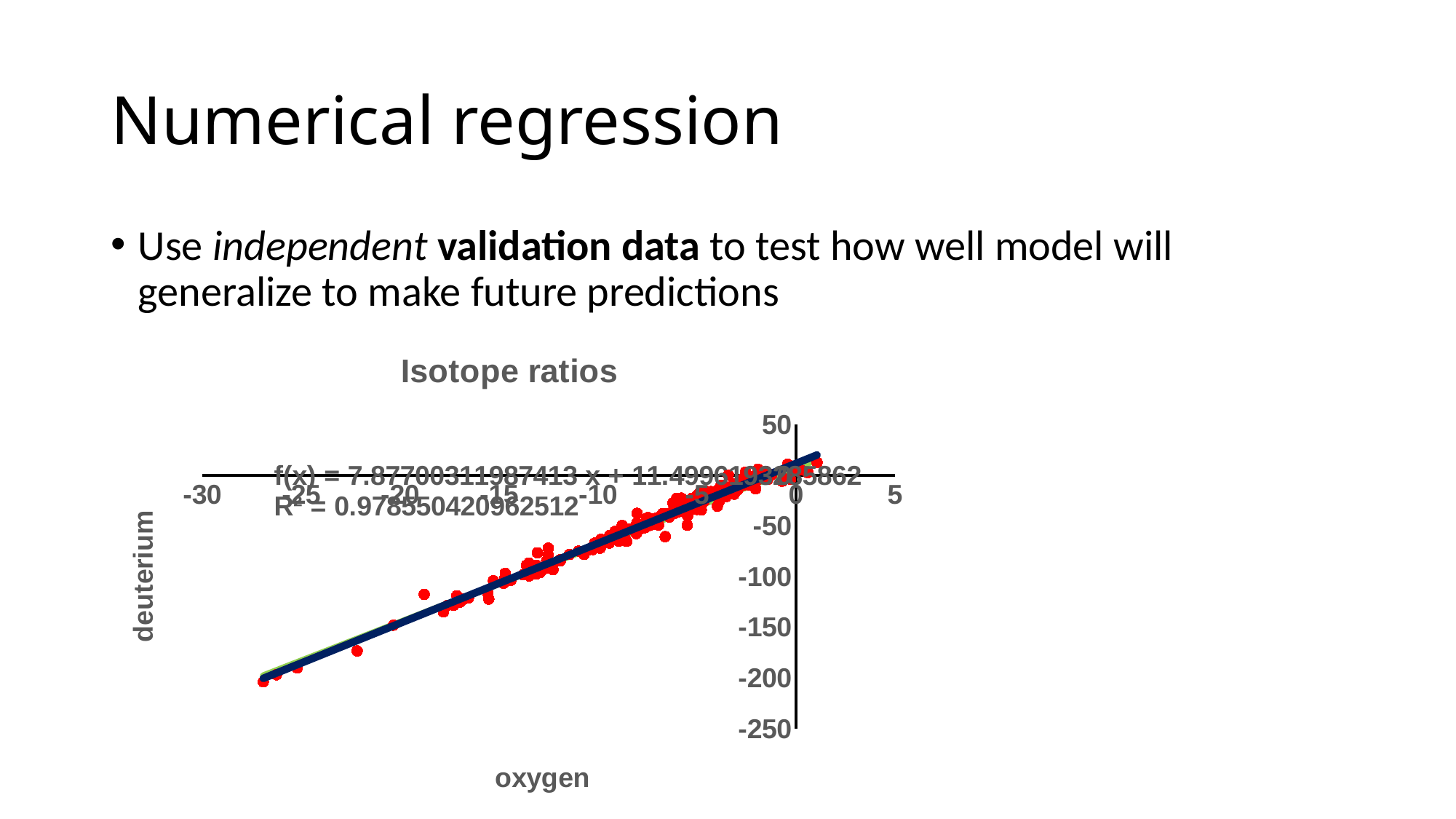
What is the label of the x axis of the chart? oxygen Is the oxygen value of the leftmost plotted point greater or less than -20? less What is the title of the chart? Isotope ratios What kind of chart is shown on the slide? scatter chart What is the slope coefficient of x in the trendline equation printed on the chart? 7.87700311987413 Do the plotted deuterium values rise or fall as oxygen increases along the x axis? rise What R² value is printed on the chart for the trendline? 0.978550420962512 Is the deuterium value of the lowest plotted point greater or less than -150? less Is the deuterium value of the rightmost plotted points greater or less than -50? greater What is the lowest tick value shown on the y axis of the chart? -250 What is the highest tick value shown on the x axis of the chart? 5